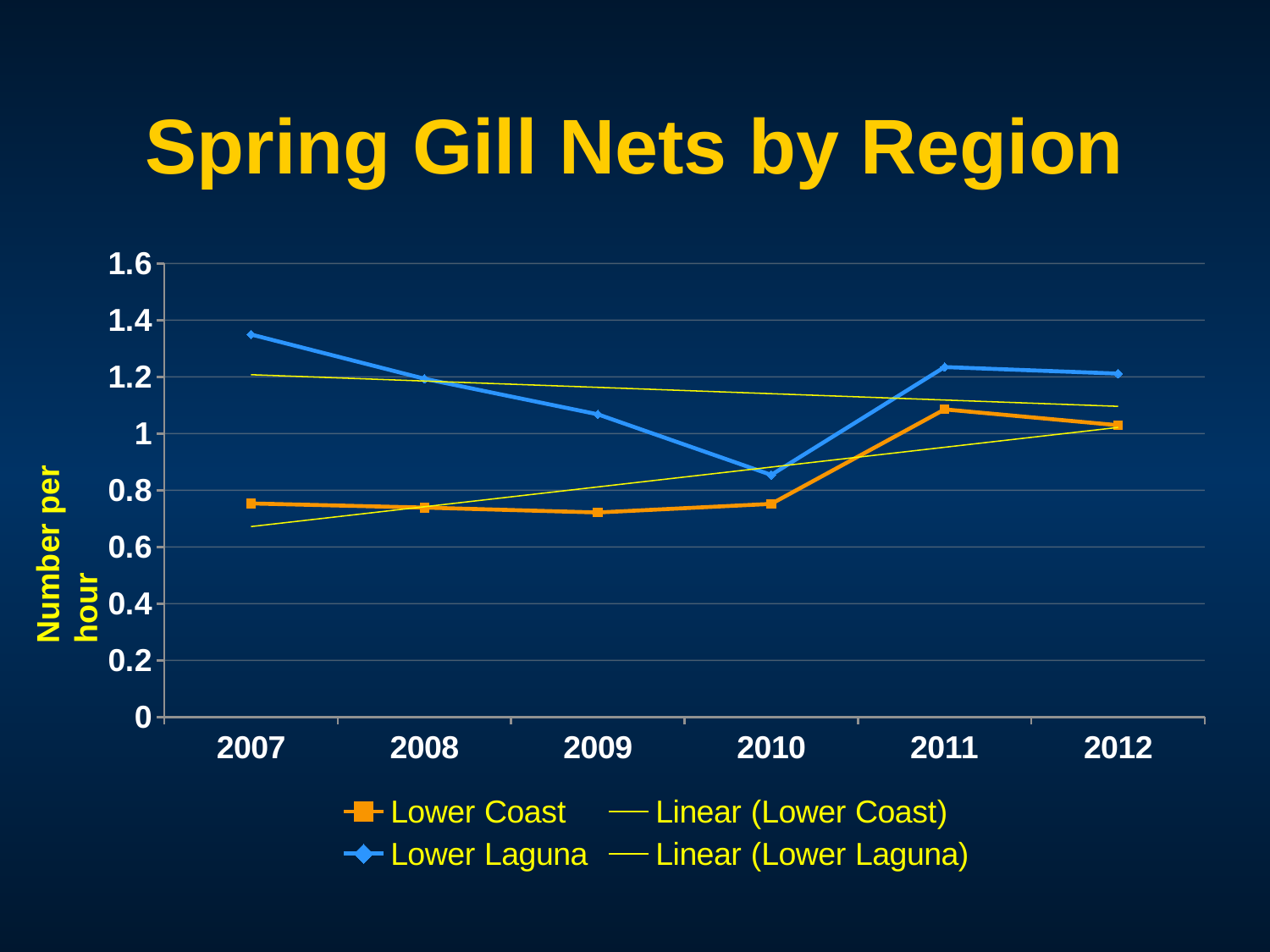
Does the Linear (Lower Coast) trendline rise or fall from 2007 to 2012? rise In which year is the Lower Laguna value highest? 2007 Is the Lower Coast value for 2009 greater or less than 0.8? less How many years are shown along the x axis? 6 In which year is the Lower Coast value highest? 2011 What is the label on the vertical axis? Number per hour Which series has the larger value in 2010, Lower Coast or Lower Laguna? Lower Laguna What kind of chart is shown on the slide? line chart Is the Lower Laguna value for 2007 greater or less than 1.2? greater How many entries does the legend list? 4 What is the title of the chart? Spring Gill Nets by Region In which year is the Lower Laguna value lowest? 2010